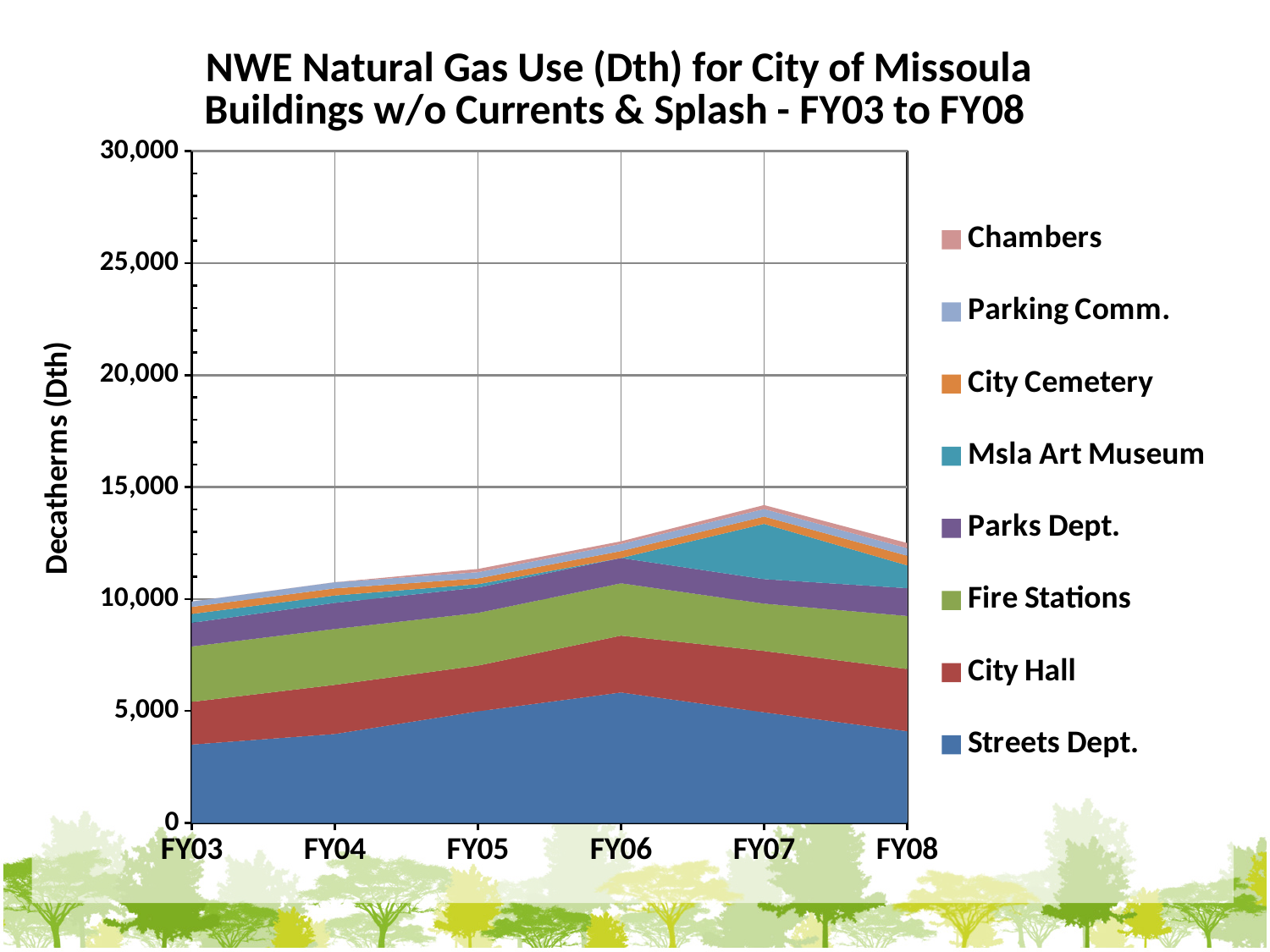
What kind of chart is shown on the slide? Stacked area chart How many fiscal years are plotted along the x axis? 6 Is the value for Streets Dept. in FY06 greater or less than 5,000? greater Is the total natural gas use in FY07 greater or less than 15,000? less Which series is listed at the top of the legend? Chambers How many series does the legend list? 8 In which fiscal year is the total natural gas use highest? FY07 In which fiscal year is the total natural gas use lowest? FY03 Does the total natural gas use rise or fall from FY03 to FY07? rise What is the label of the y axis? Decatherms (Dth) In FY03, which uses more natural gas: Streets Dept. or City Hall? Streets Dept. Is the total natural gas use in FY06 greater or less than 10,000? greater